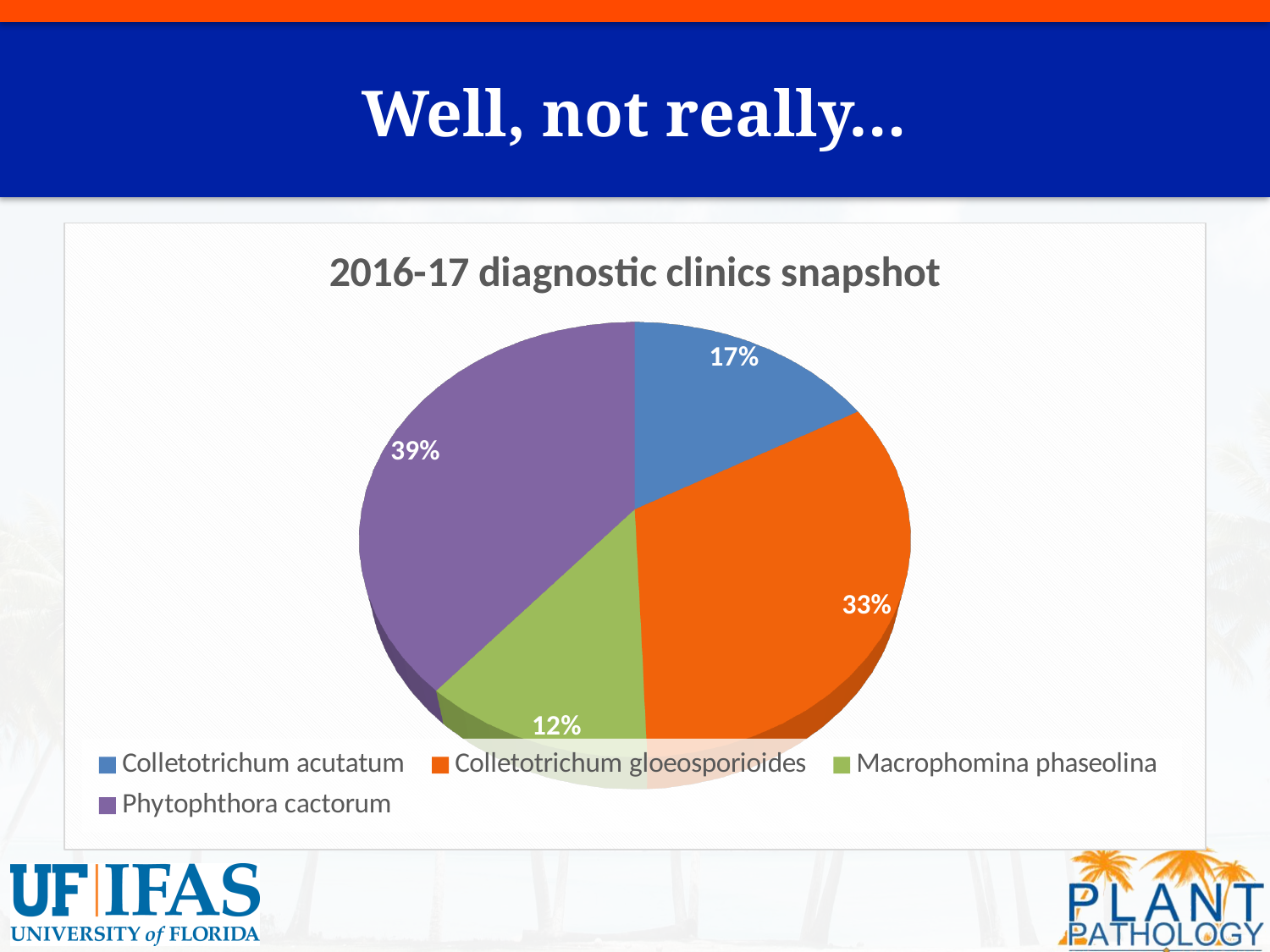
Which colour represents Macrophomina phaseolina in the chart? green Which is larger, the share for Colletotrichum gloeosporioides or the share for Colletotrichum acutatum? Colletotrichum gloeosporioides What kind of chart is shown on the slide? pie chart What is the difference in percentage points between Phytophthora cactorum and Colletotrichum acutatum? 22 What share of the pie does Phytophthora cactorum represent? 39% What share of the pie does Macrophomina phaseolina represent? 12% How many categories are shown in the pie chart? 4 What share of the pie does Colletotrichum acutatum represent? 17% Which category has the largest slice of the pie? Phytophthora cactorum What is the title of the chart? 2016-17 diagnostic clinics snapshot Which category has the smallest slice of the pie? Macrophomina phaseolina